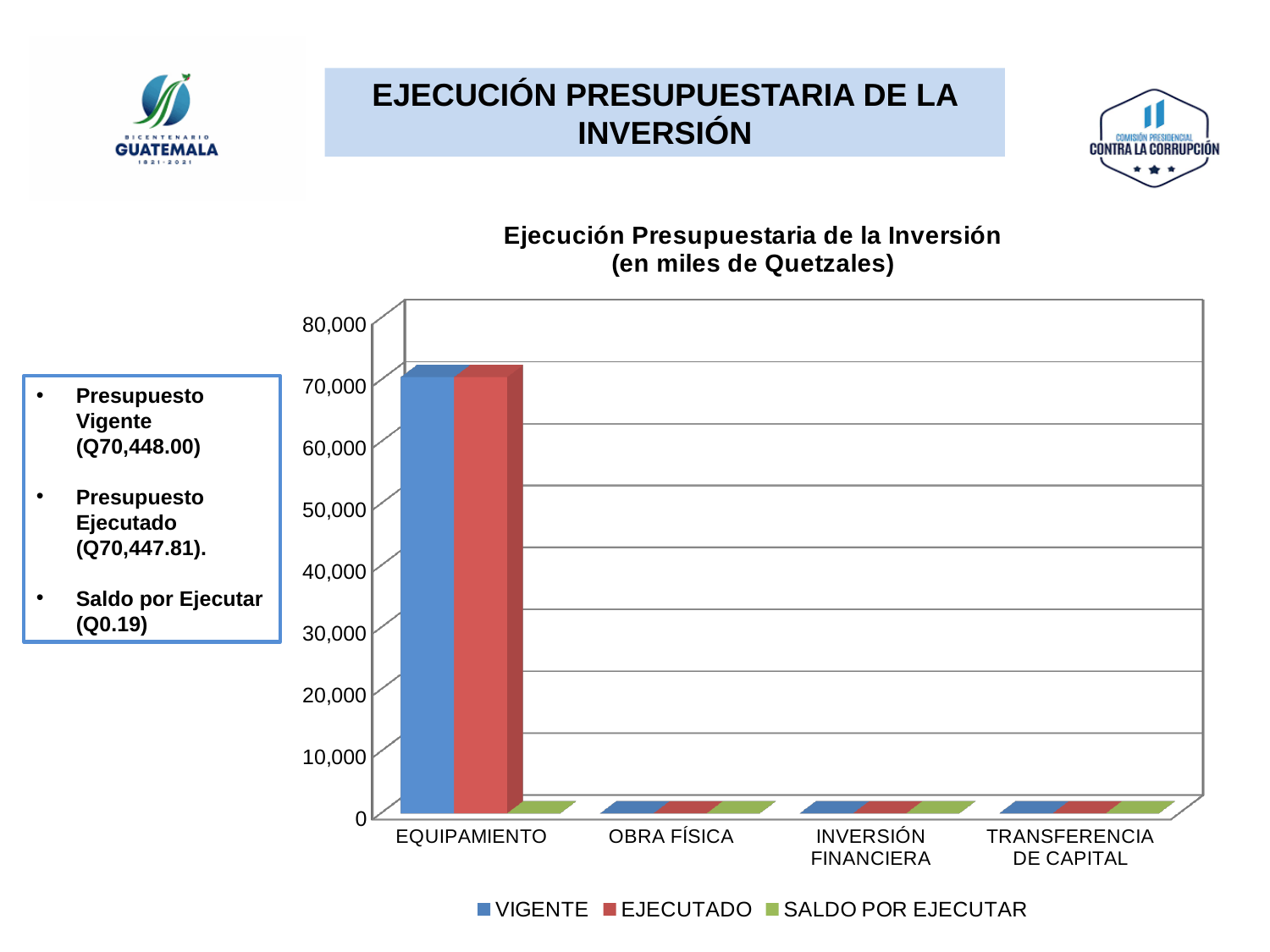
Is the EJECUTADO value for EQUIPAMIENTO greater or less than 80,000? less Is the VIGENTE value for OBRA FÍSICA greater or less than 10,000? less Which is larger: the VIGENTE value for EQUIPAMIENTO or the VIGENTE value for INVERSIÓN FINANCIERA? EQUIPAMIENTO What is the title of the chart? Ejecución Presupuestaria de la Inversión (en miles de Quetzales) Which category has the highest VIGENTE value? EQUIPAMIENTO What kind of chart is shown on the slide? bar chart How many categories are shown on the x axis of the chart? 4 How many series does the chart legend list? 3 Which series is shown in green in the chart legend? SALDO POR EJECUTAR Is the VIGENTE value for EQUIPAMIENTO greater or less than 60,000? greater Which category has the highest EJECUTADO value? EQUIPAMIENTO